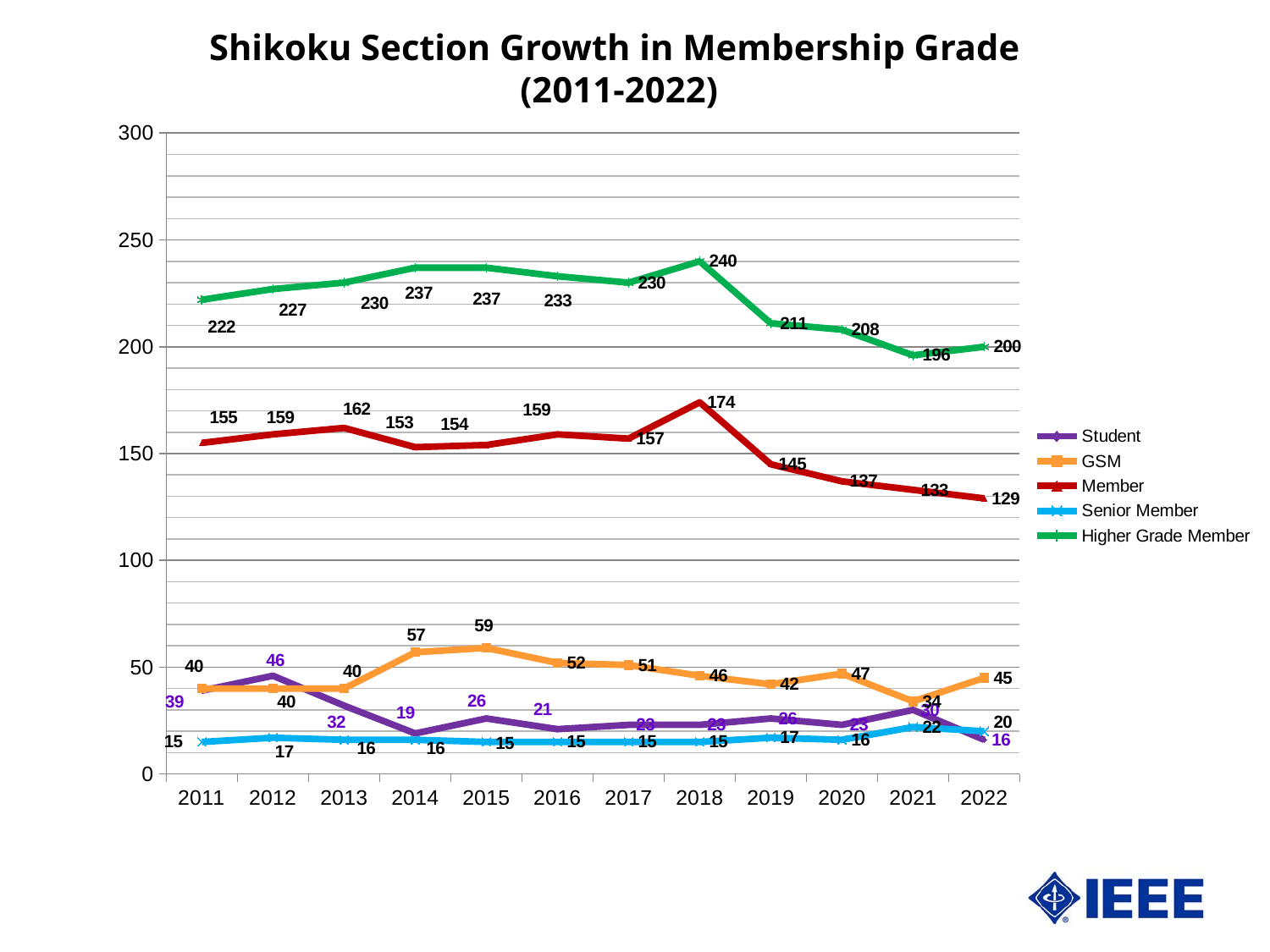
What is the Member value in 2022? 129 How many series does the legend list? 5 In 2011, which is larger: the Student value or the Senior Member value? Student In which year does the Higher Grade Member series reach its highest value? 2018 What is the Higher Grade Member value in 2018? 240 How many years are plotted along the x axis? 12 By how much did the Member value fall from 2018 to 2022? 45 What is the GSM value in 2015? 59 Is the Higher Grade Member value in 2011 greater or less than 200? greater Does the Member series rise or fall from 2018 to 2022? fall What type of chart is shown on the slide? line chart In which year is the Member value lowest? 2022